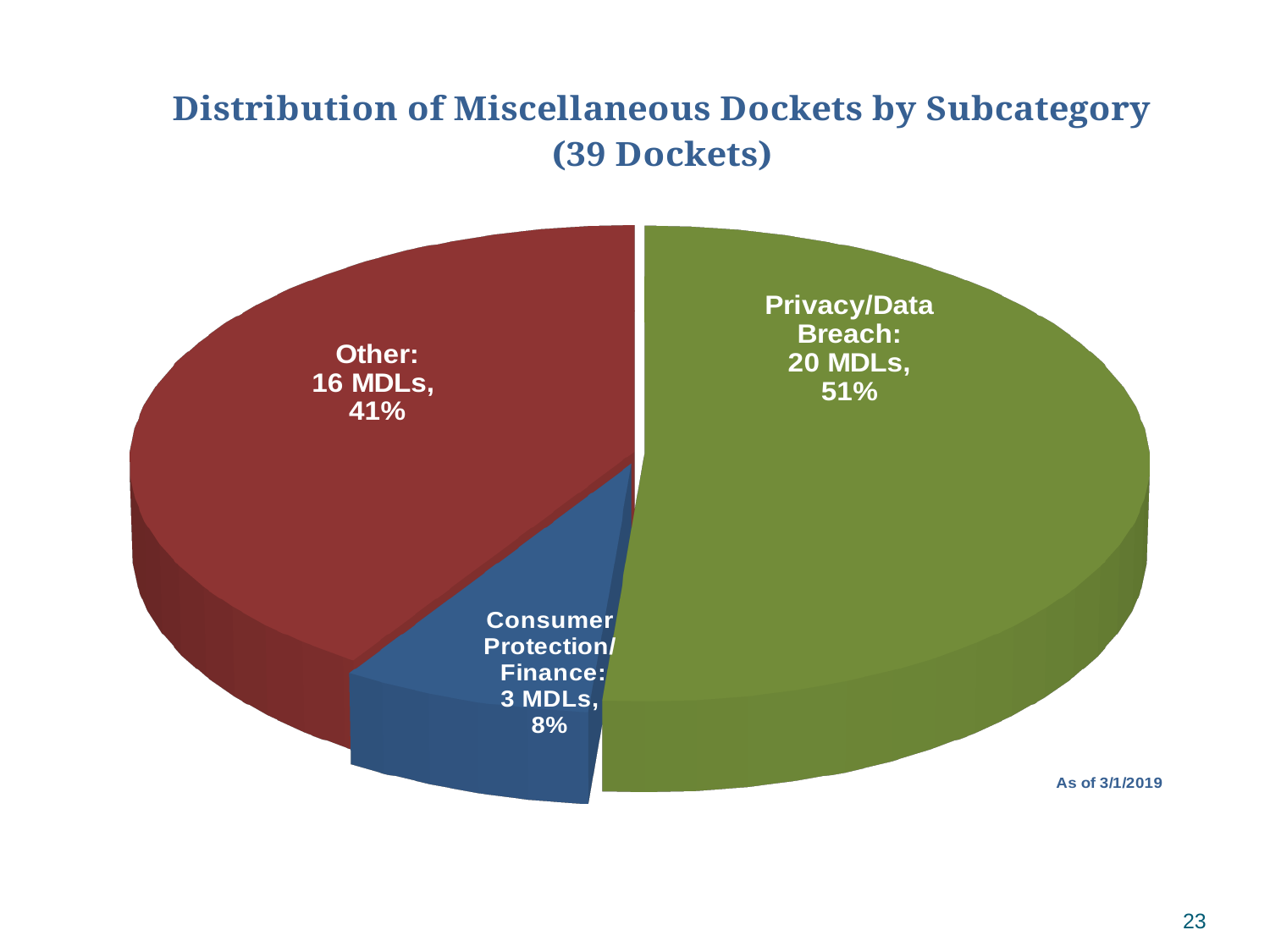
How many MDLs are in the Consumer Protection/Finance slice? 3 MDLs What kind of chart is shown on the slide? Pie chart How many more MDLs does Privacy/Data Breach have than Other? 4 What is the 'as of' date shown on the slide? 3/1/2019 Which subcategory has the largest number of MDLs? Privacy/Data Breach What is the total number of dockets stated in the chart title? 39 Dockets What share of the pie is the Privacy/Data Breach slice? 51% Which has more MDLs, Other or Consumer Protection/Finance? Other Which subcategory has the smallest number of MDLs? Consumer Protection/Finance How many MDLs are in the Privacy/Data Breach slice? 20 MDLs How many slices does the pie chart have? 3 What percentage of the pie does the Other slice represent? 41%